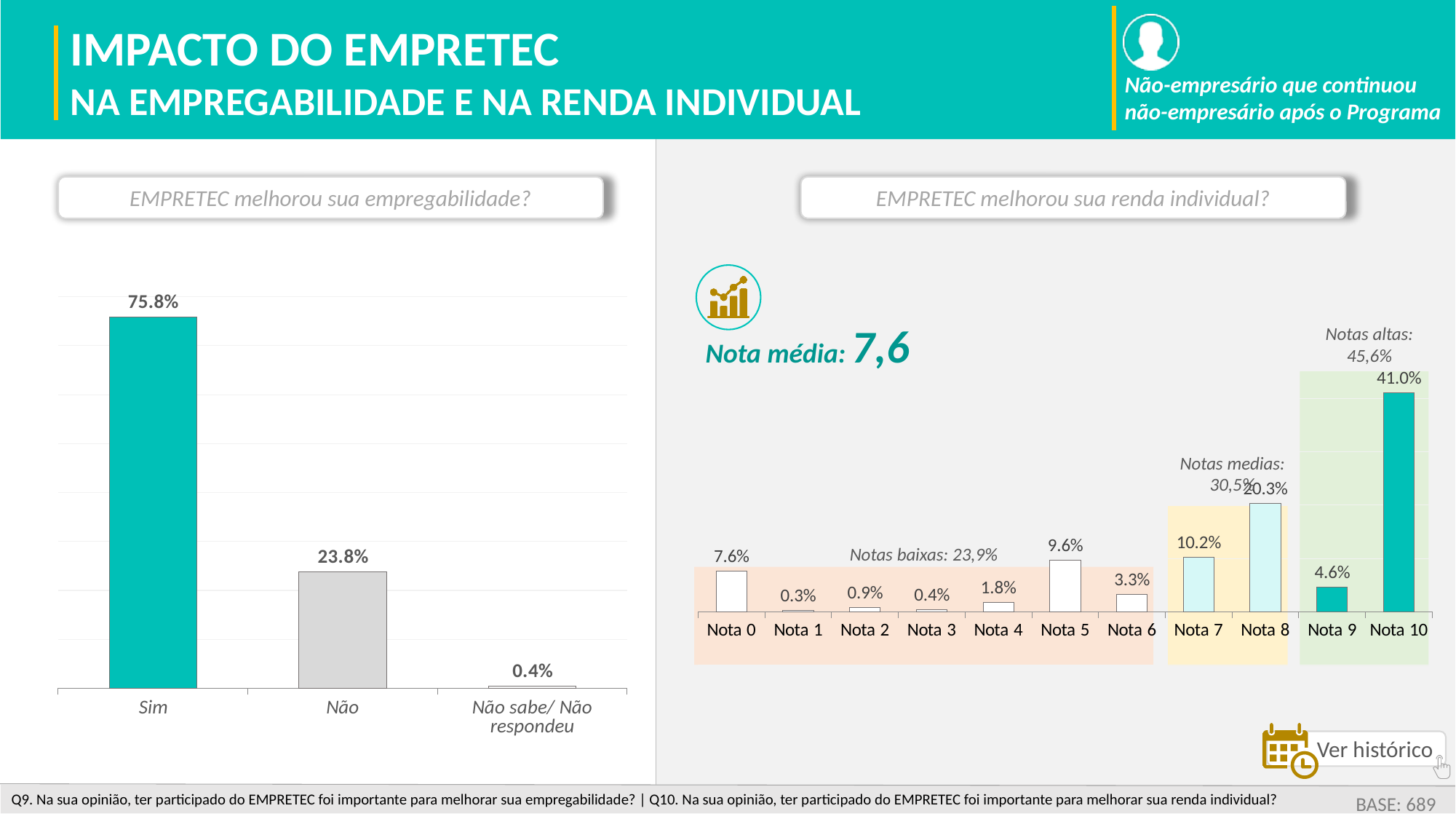
In the chart 'EMPRETEC melhorou sua renda individual?', which category has the highest value? Nota 10 In the chart 'EMPRETEC melhorou sua empregabilidade?', how many categories are shown? 3 In the chart 'EMPRETEC melhorou sua empregabilidade?', what is the value for 'Sim'? 75.8% In the chart 'EMPRETEC melhorou sua empregabilidade?', what is the value for 'Não'? 23.8% In the chart 'EMPRETEC melhorou sua renda individual?', how many categories are shown? 11 In the chart 'EMPRETEC melhorou sua renda individual?', what is the value for 'Nota 10'? 41.0% What kind of chart is 'EMPRETEC melhorou sua renda individual?'? Bar chart In the chart 'EMPRETEC melhorou sua renda individual?', which is larger, 'Nota 7' or 'Nota 9'? Nota 7 In the chart 'EMPRETEC melhorou sua renda individual?', what is the value for 'Nota 5'? 9.6% In the chart 'EMPRETEC melhorou sua renda individual?', which category has the lowest value? Nota 1 In the chart 'EMPRETEC melhorou sua empregabilidade?', what is the difference between 'Sim' and 'Não'? 52.0% In the chart 'EMPRETEC melhorou sua empregabilidade?', which category has the lowest value? Não sabe/ Não respondeu